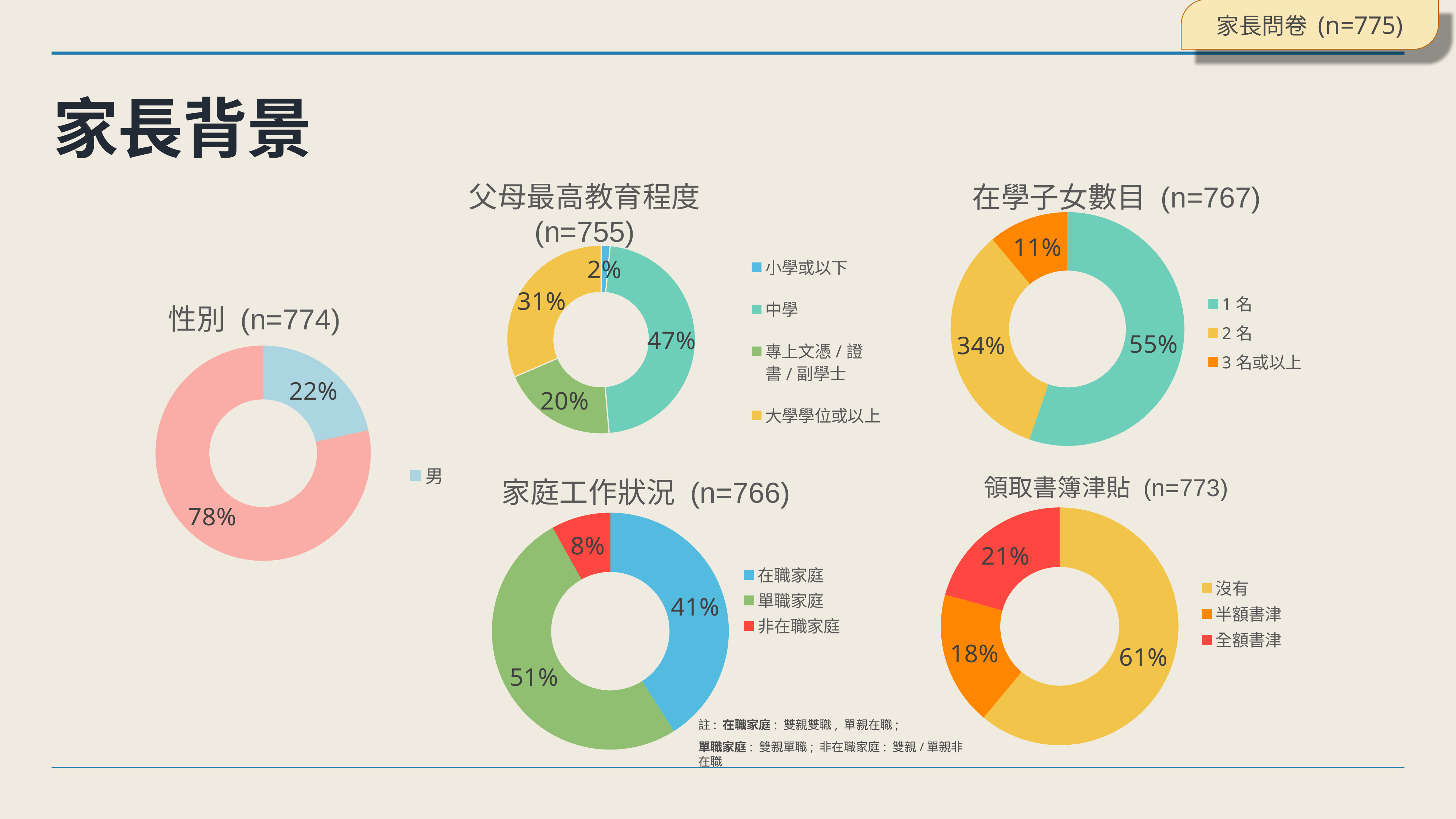
In the 性別 (n=774) chart, what percentage is shown for 男? 22% In the 家庭工作狀況 (n=766) chart, what percentage is shown for 非在職家庭? 8% In the 領取書簿津貼 (n=773) chart, what is the difference between the shares for 沒有 and 半額書津? 43% In the 在學子女數目 (n=767) chart, which category has the largest share? 1 名 In the 領取書簿津貼 (n=773) chart, what percentage is shown for 全額書津? 21% In the 家庭工作狀況 (n=766) chart, which is larger, 在職家庭 or 單職家庭? 單職家庭 How many categories does the legend of the 在學子女數目 (n=767) chart list? 3 What type of chart is the 性別 (n=774) chart? Donut chart In the 父母最高教育程度 (n=755) chart, what percentage is shown for 中學? 47% In the 在學子女數目 (n=767) chart, what percentage is shown for 2 名? 34% In the 父母最高教育程度 (n=755) chart, what is the difference between the shares for 大學學位或以上 and 專上文憑 / 證書 / 副學士? 11% In the 父母最高教育程度 (n=755) chart, which category has the smallest share? 小學或以下